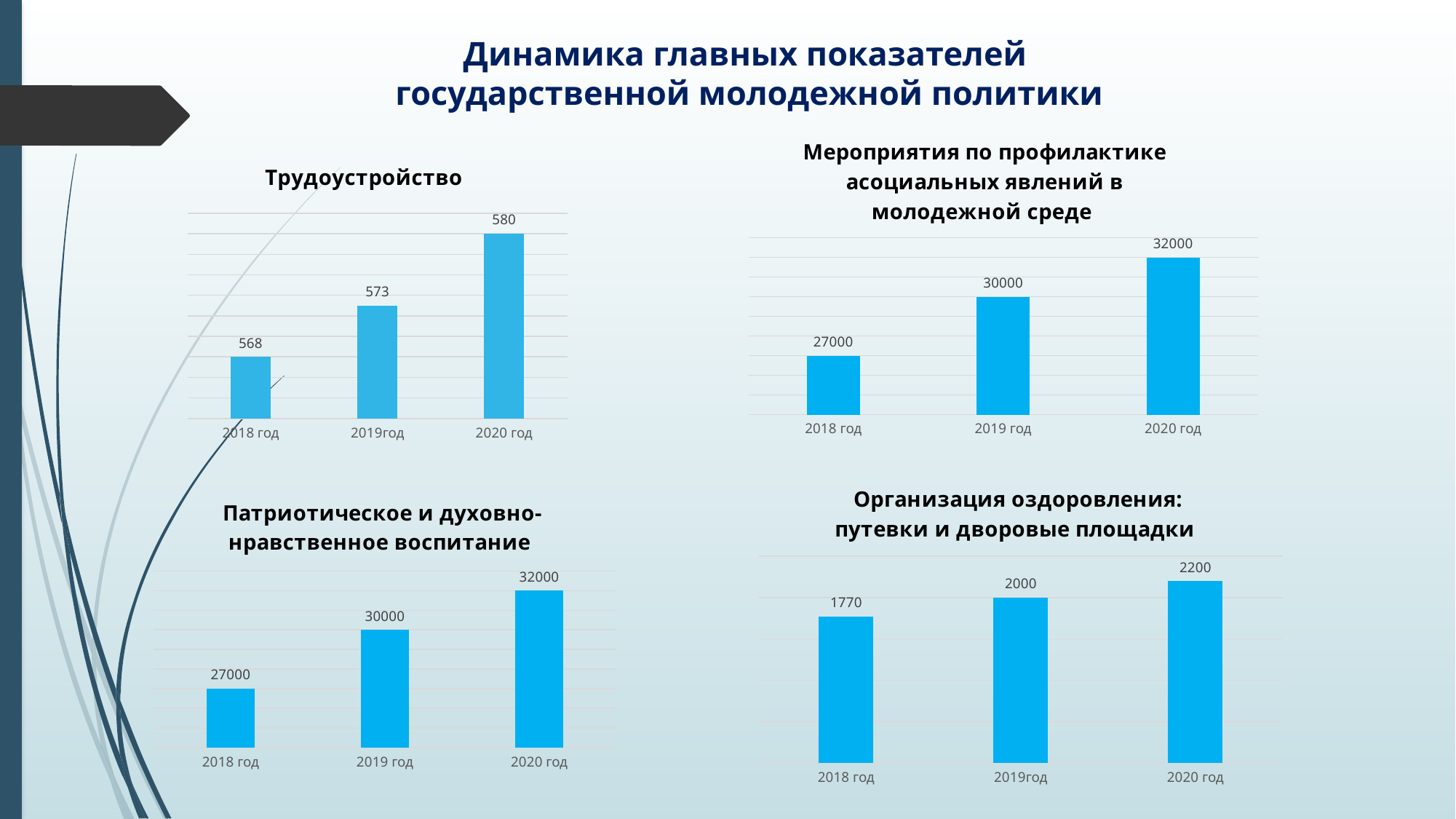
In the 'Трудоустройство' chart, what is the difference between the 2020 год and 2018 год values? 12 In the 'Трудоустройство' chart, what is the value for 2020 год? 580 In the 'Патриотическое и духовно-нравственное воспитание' chart, what is the value for 2018 год? 27000 In the 'Трудоустройство' chart, which year has the lowest value? 2018 год In the 'Мероприятия по профилактике асоциальных явлений в молодежной среде' chart, what is the value for 2019 год? 30000 How many bars are in the 'Организация оздоровления: путевки и дворовые площадки' chart? 3 In the 'Организация оздоровления: путевки и дворовые площадки' chart, what is the value for 2018 год? 1770 What kind of chart is the 'Трудоустройство' chart? bar chart In the 'Мероприятия по профилактике асоциальных явлений в молодежной среде' chart, what is the difference between the 2020 год and 2018 год values? 5000 In the 'Мероприятия по профилактике асоциальных явлений в молодежной среде' chart, which year has the highest value? 2020 год In the 'Патриотическое и духовно-нравственное воспитание' chart, do the values rise or fall from 2018 год to 2020 год? rise In the 'Организация оздоровления: путевки и дворовые площадки' chart, which is larger, the value for 2019год or 2020 год? 2020 год